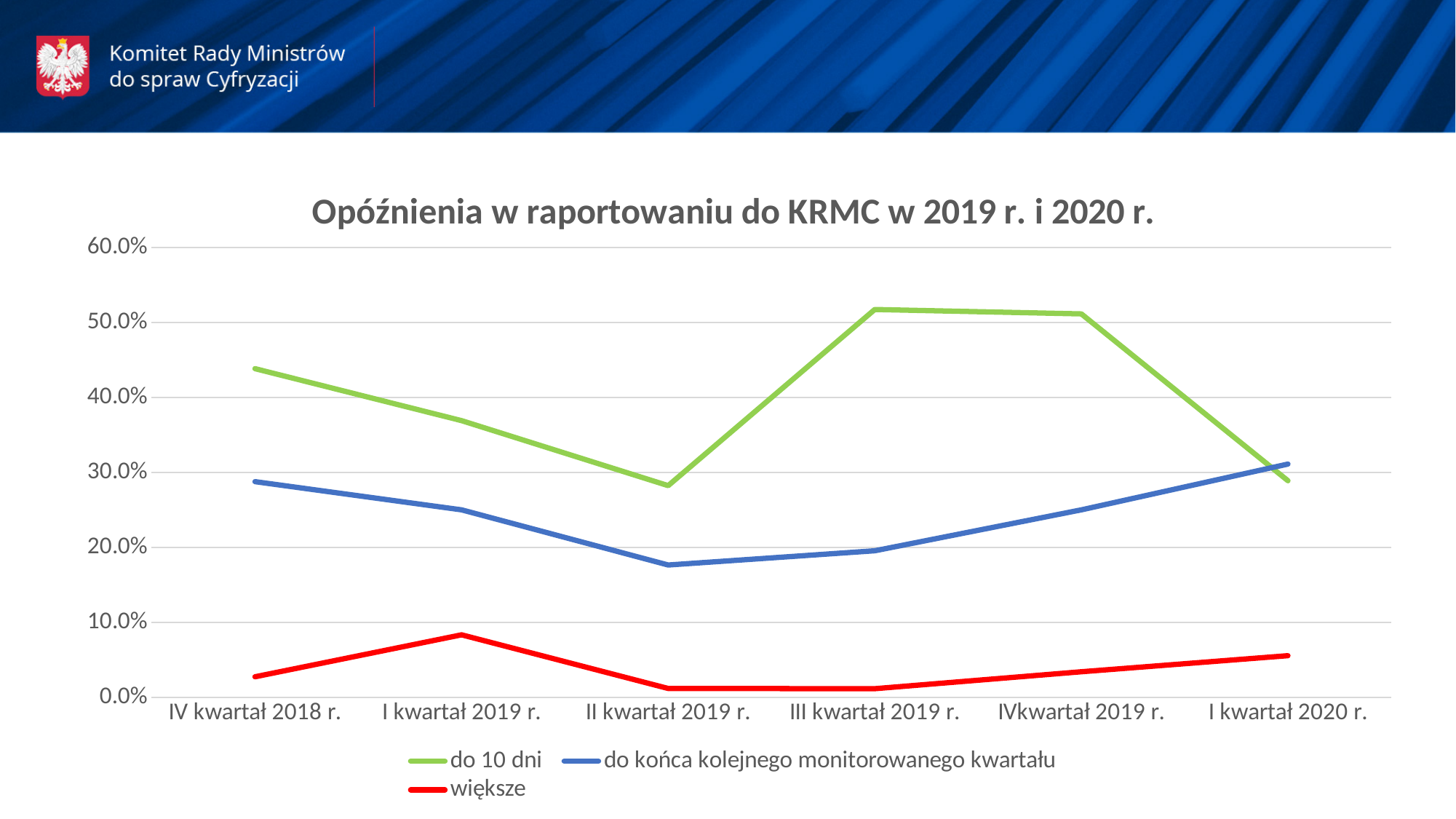
What is the title of the chart? Opóźnienia w raportowaniu do KRMC w 2019 r. i 2020 r. Which colour is the line for the series 'większe'? red How many series does the legend list? 3 Does the series 'do końca kolejnego monitorowanego kwartału' rise or fall from II kwartał 2019 r. to I kwartał 2020 r.? rise In III kwartał 2019 r., which series has the larger value: 'do 10 dni' or 'do końca kolejnego monitorowanego kwartału'? do 10 dni Is the value for 'większe' in I kwartał 2019 r. greater or less than 10.0%? less Is the value for 'do 10 dni' in III kwartał 2019 r. greater or less than 50.0%? greater Is the value for 'do 10 dni' in IV kwartał 2018 r. greater or less than 40.0%? greater In which quarter does the series 'większe' reach its highest value? I kwartał 2019 r. What kind of chart is shown on the slide? line chart How many quarters are shown on the x axis? 6